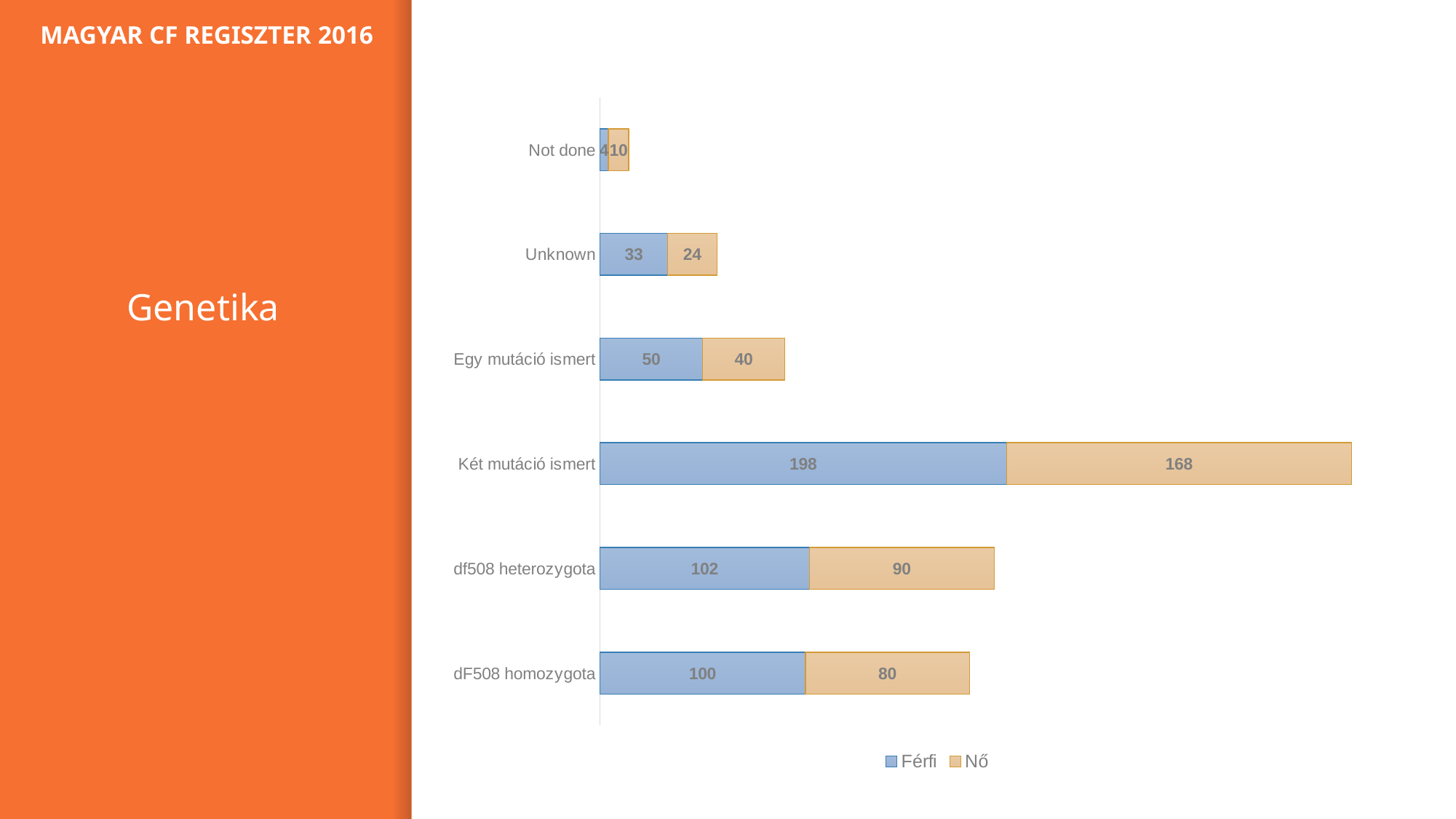
What kind of chart is shown on the slide? Stacked bar chart Which is larger for Unknown, the Férfi value or the Nő value? Férfi What is the Nő value for df508 heterozygota? 90 What is the Nő value for Egy mutáció ismert? 40 Which category has the highest Férfi value? Két mutáció ismert How many categories are shown on the chart? 6 What is the Férfi value for dF508 homozygota? 100 How many series does the legend list? 2 What is the Férfi value for Két mutáció ismert? 198 What is the total of the stacked bar for dF508 homozygota? 180 Which category has the lowest Nő value? Not done What is the difference between the Férfi and Nő values for Két mutáció ismert? 30